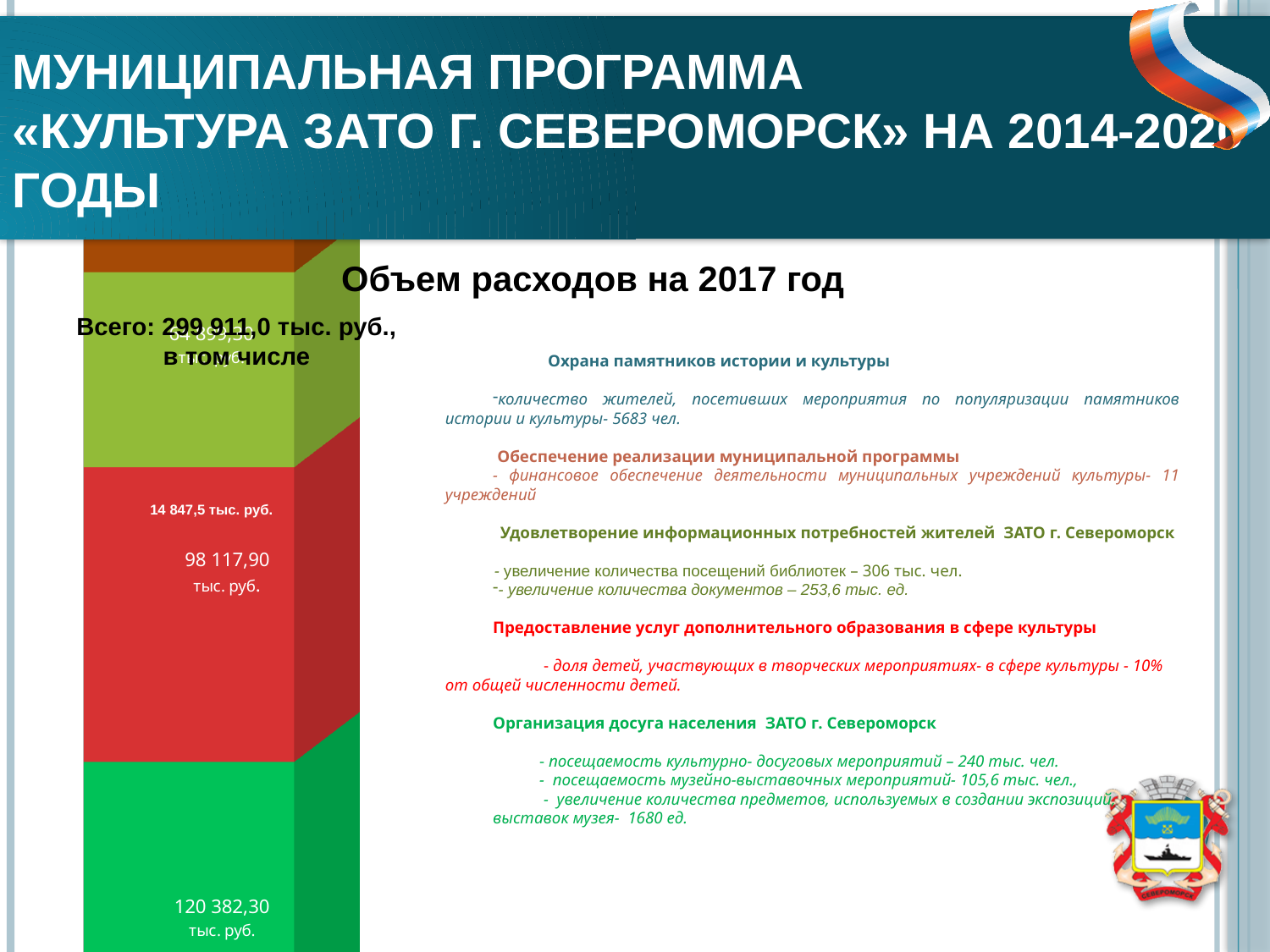
What value is printed on the bottom (green) segment of the stacked bar? 120 382,30 тыс. руб. What total amount is stated above the chart for 2017? 299 911,0 тыс. руб. What colour is the segment labelled 98 117,90 тыс. руб.? Red Is the value of the red segment greater or less than 100 000 тыс. руб.? less Which segment of the stacked bar is larger: the green bottom segment or the red segment? The green bottom segment What is the difference between the green bottom segment (120 382,30) and the red segment (98 117,90)? 22 264,40 тыс. руб. Which labelled segment of the stacked bar has the largest value? The green bottom segment (120 382,30 тыс. руб.) What kind of chart is shown on the slide? Stacked bar chart What value is printed on the red segment of the stacked bar? 98 117,90 тыс. руб. What is the title of the chart on the slide? Объем расходов на 2017 год